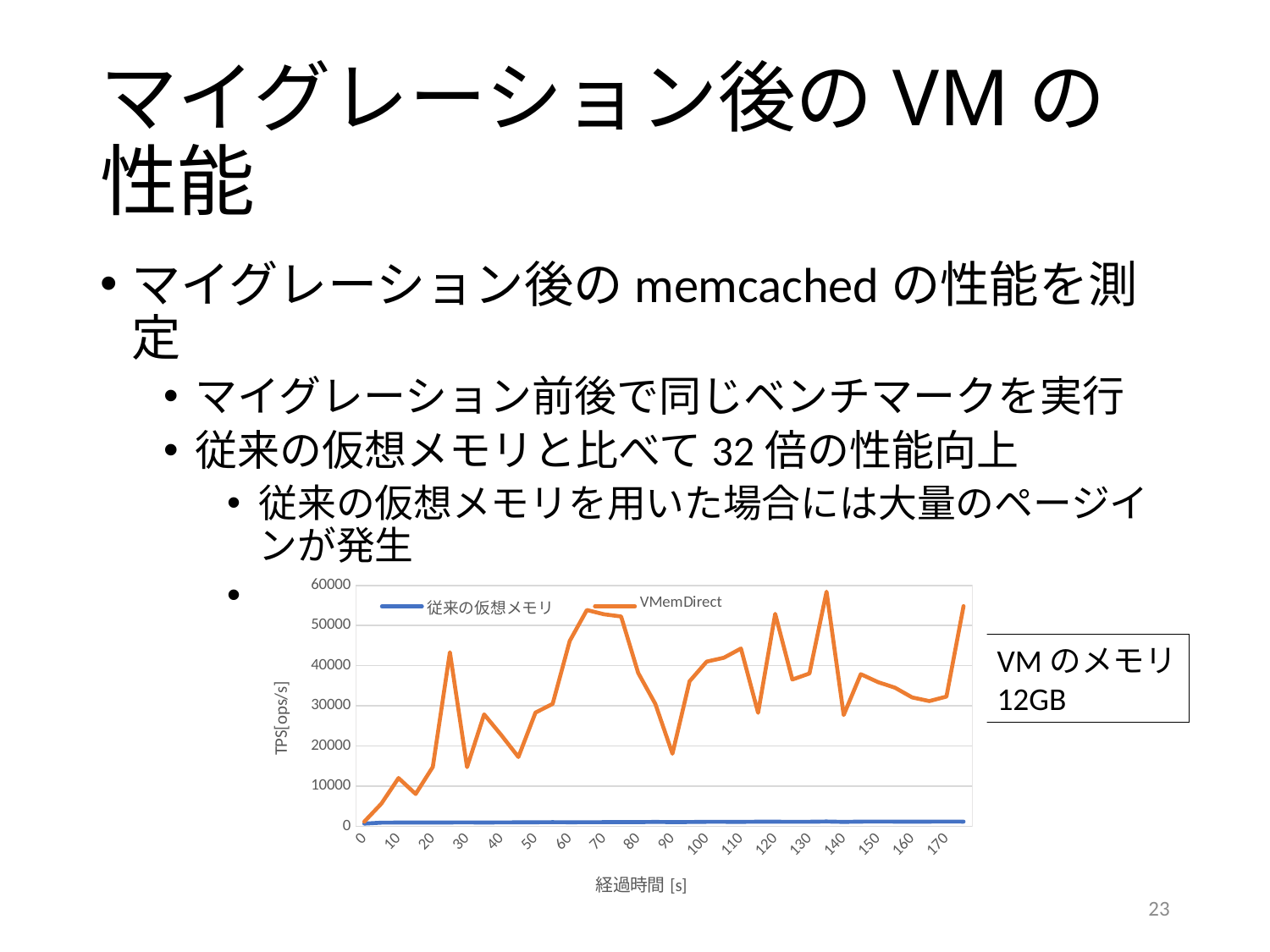
Is the value of 従来の仮想メモリ at 100 s greater or less than 10000? less What is the highest tick value shown on the vertical axis? 60000 Is the value of VMemDirect at 90 s greater or less than 30000? less Is the value of VMemDirect at 0 s greater or less than 10000? less Does the VMemDirect series generally rise or fall between 0 s and 20 s? rise How many series does the chart legend list? 2 Which series has higher values across the chart, 従来の仮想メモリ or VMemDirect? VMemDirect What are the two series named in the chart legend? 従来の仮想メモリ and VMemDirect What is the label of the vertical axis of the chart? TPS[ops/s] What kind of chart is shown on the slide? line chart